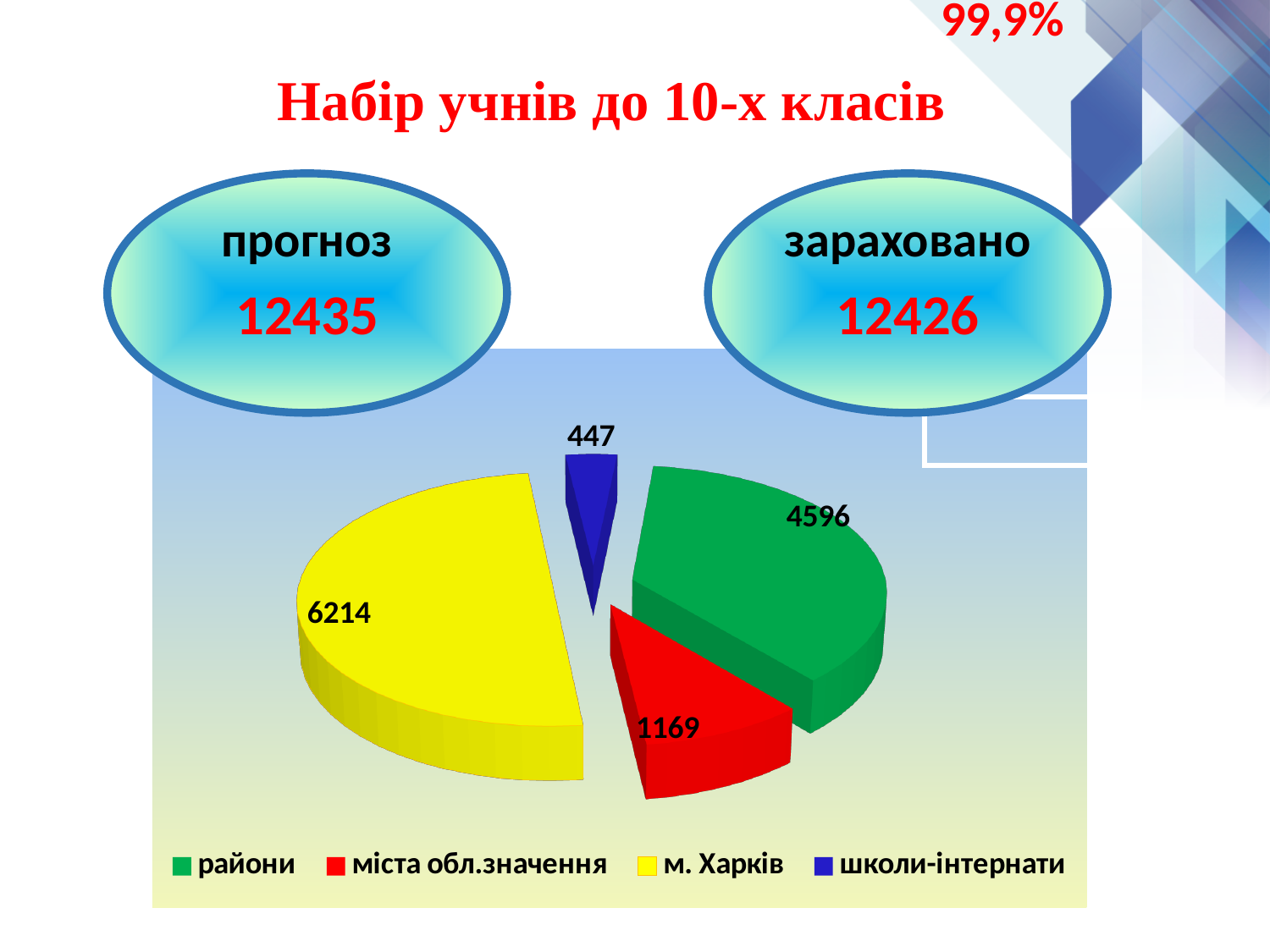
Which colour represents школи-інтернати in the legend? blue What is the value for міста обл.значення in the pie chart? 1169 What is the total of all slices in the pie chart? 12426 Which category has the smallest slice in the pie chart? школи-інтернати Which is larger, the value for райони or the value for міста обл.значення? райони What is the value for школи-інтернати in the pie chart? 447 What type of chart is shown on the slide? pie chart How many categories does the pie chart have? 4 What is the difference between the values for м. Харків and райони? 1618 What is the value for м. Харків in the pie chart? 6214 Which category has the largest slice in the pie chart? м. Харків What is the value for райони in the pie chart? 4596